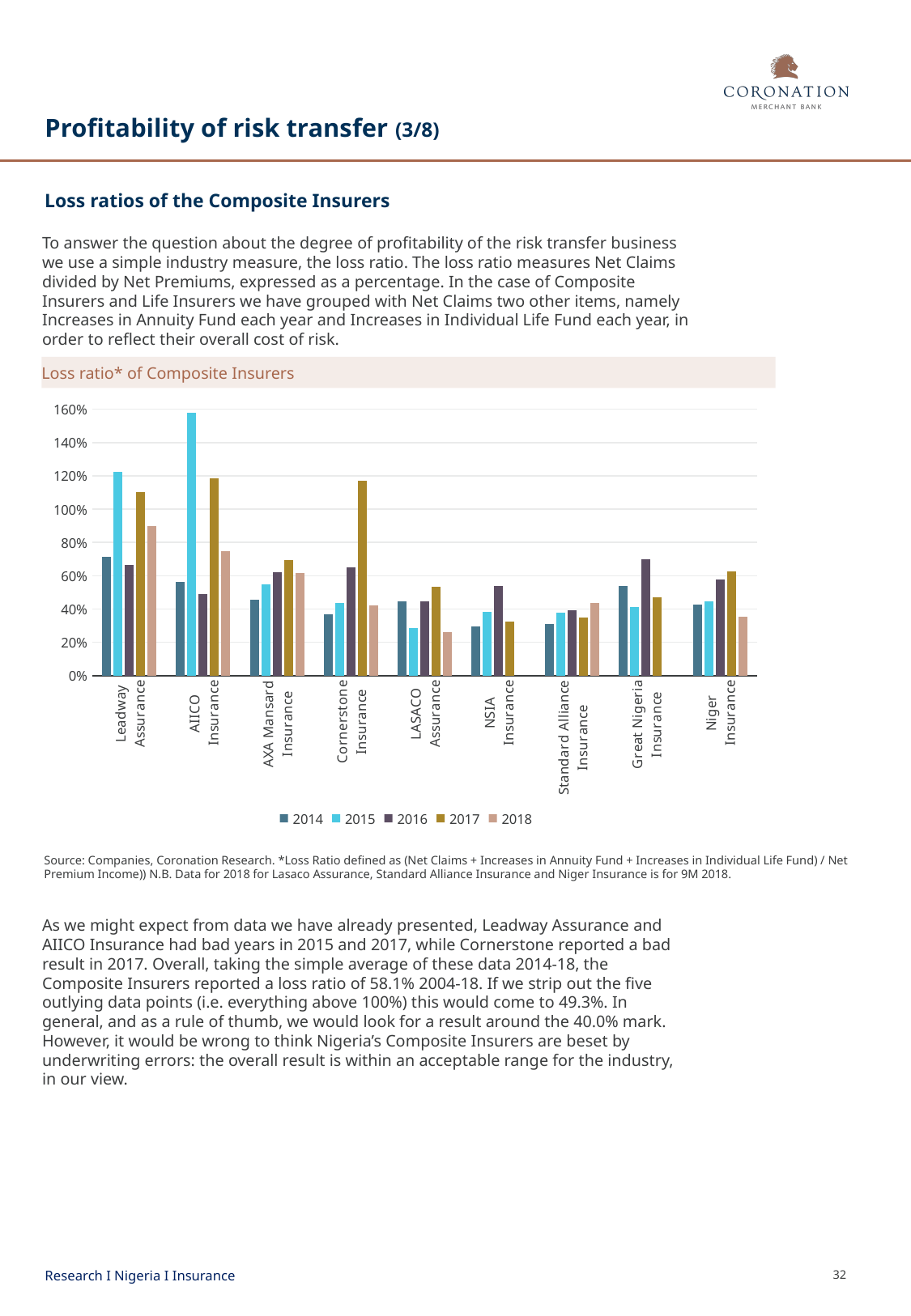
What is the title of the chart on the slide? Loss ratio* of Composite Insurers Is the 2015 loss ratio for Leadway Assurance greater or less than 100%? greater What kind of chart is used to show the loss ratios of Composite Insurers? Bar chart Which insurer and year has the highest loss ratio bar in the chart? AIICO Insurance, 2015 Is the 2018 loss ratio for LASACO Assurance greater or less than 40%? less Which year is represented by the light blue bars in the chart? 2015 For Cornerstone Insurance, which year has the larger loss ratio, 2014 or 2017? 2017 How many series (years) does the legend of the loss ratio chart list? 5 How many insurers are shown on the x axis of the loss ratio chart? 9 Is the 2016 loss ratio for NSIA Insurance greater or less than 40%? greater Which insurer had the larger loss ratio in 2015, Leadway Assurance or AIICO Insurance? AIICO Insurance